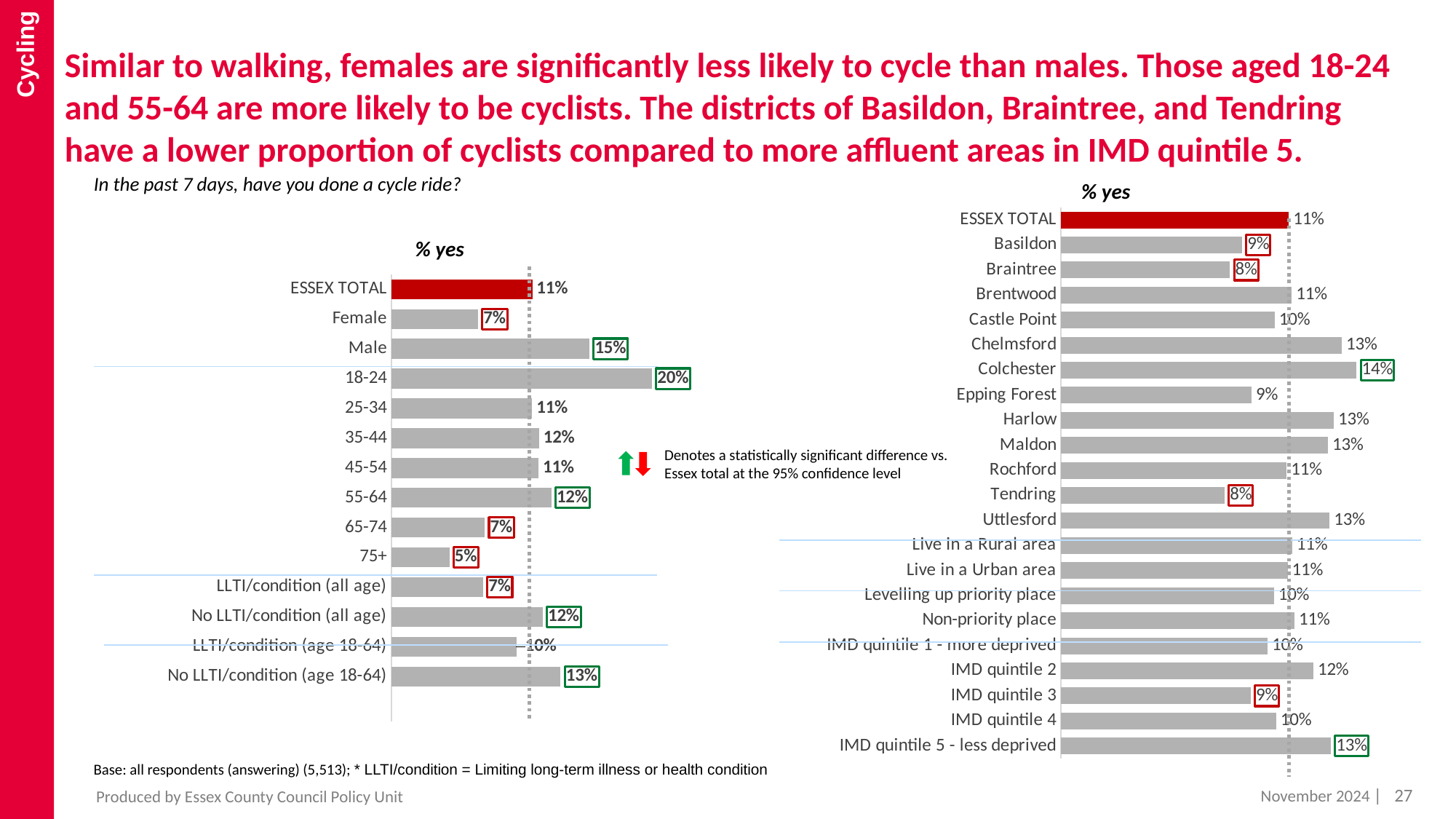
In the right-hand chart, which is larger: Chelmsford or Epping Forest? Chelmsford In the right-hand chart, what is the value for Colchester? 14% How many bars are plotted in the right-hand chart? 22 In the right-hand chart, what is the difference between IMD quintile 5 - less deprived and IMD quintile 1 - more deprived? 3% In the left-hand chart, what percentage of females said yes to having done a cycle ride in the past 7 days? 7% In the left-hand chart, which category has the lowest value? 75+ In the left-hand chart, what is the difference between the Male and Female values? 8% In the left-hand chart, which is larger: No LLTI/condition (age 18-64) or LLTI/condition (age 18-64)? No LLTI/condition (age 18-64) In the right-hand chart, which district has the highest value? Colchester In the left-hand chart, what is the value for the 18-24 age group? 20% What type of chart is used on this slide? Bar chart In the right-hand chart, what is the value for Tendring? 8%